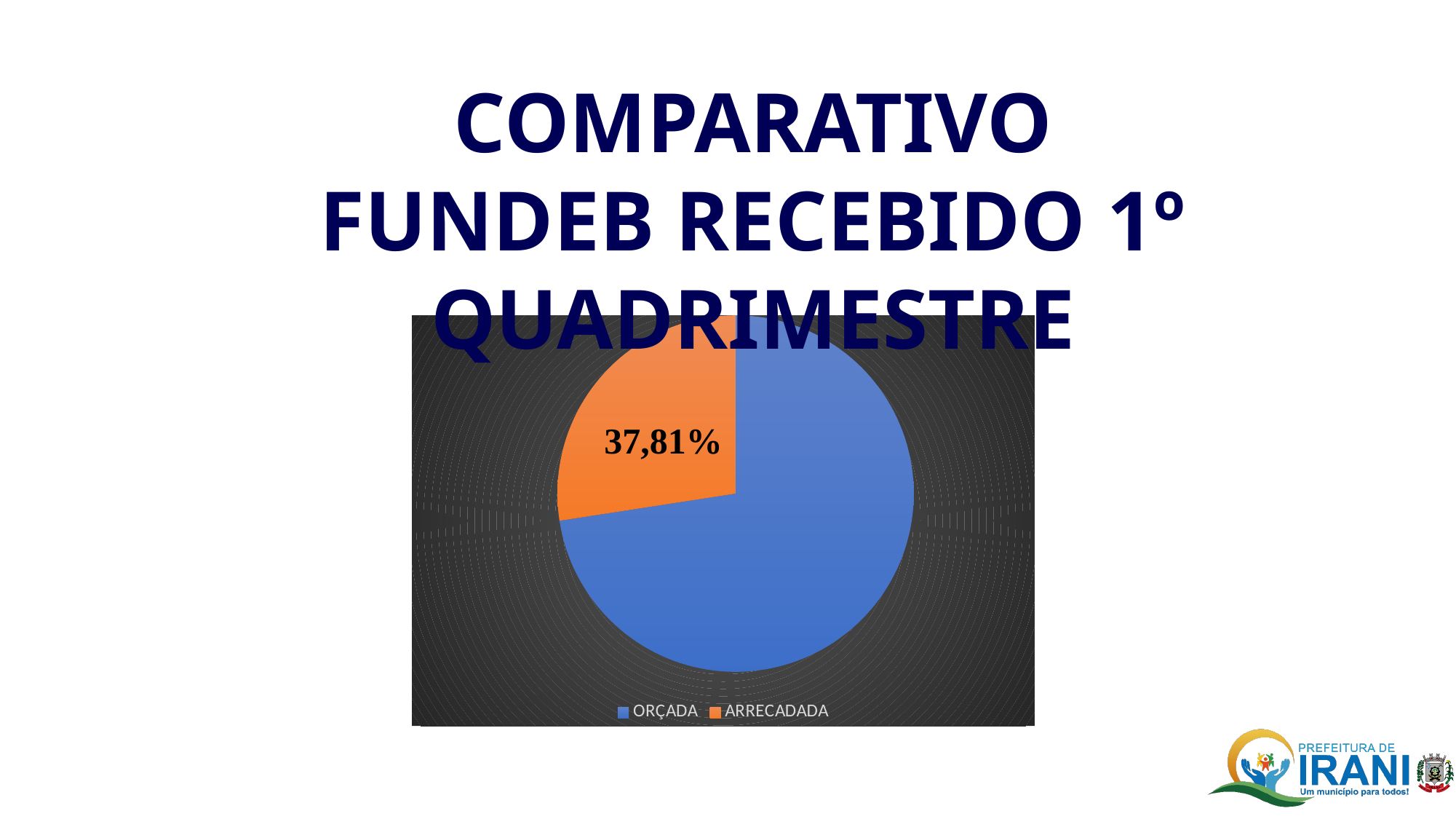
How many slices does the pie chart have? 2 What colour is the ORÇADA slice in the pie chart? blue Which slice of the pie chart is the smallest? ARRECADADA What kind of chart is shown on the slide? pie chart What is the title of the slide containing the pie chart? COMPARATIVO FUNDEB RECEBIDO 1º QUADRIMESTRE Which is larger in the pie chart, ORÇADA or ARRECADADA? ORÇADA What percentage is shown for the ARRECADADA slice of the pie chart? 37,81% How many entries does the legend of the pie chart list? 2 Which slice of the pie chart is the largest? ORÇADA